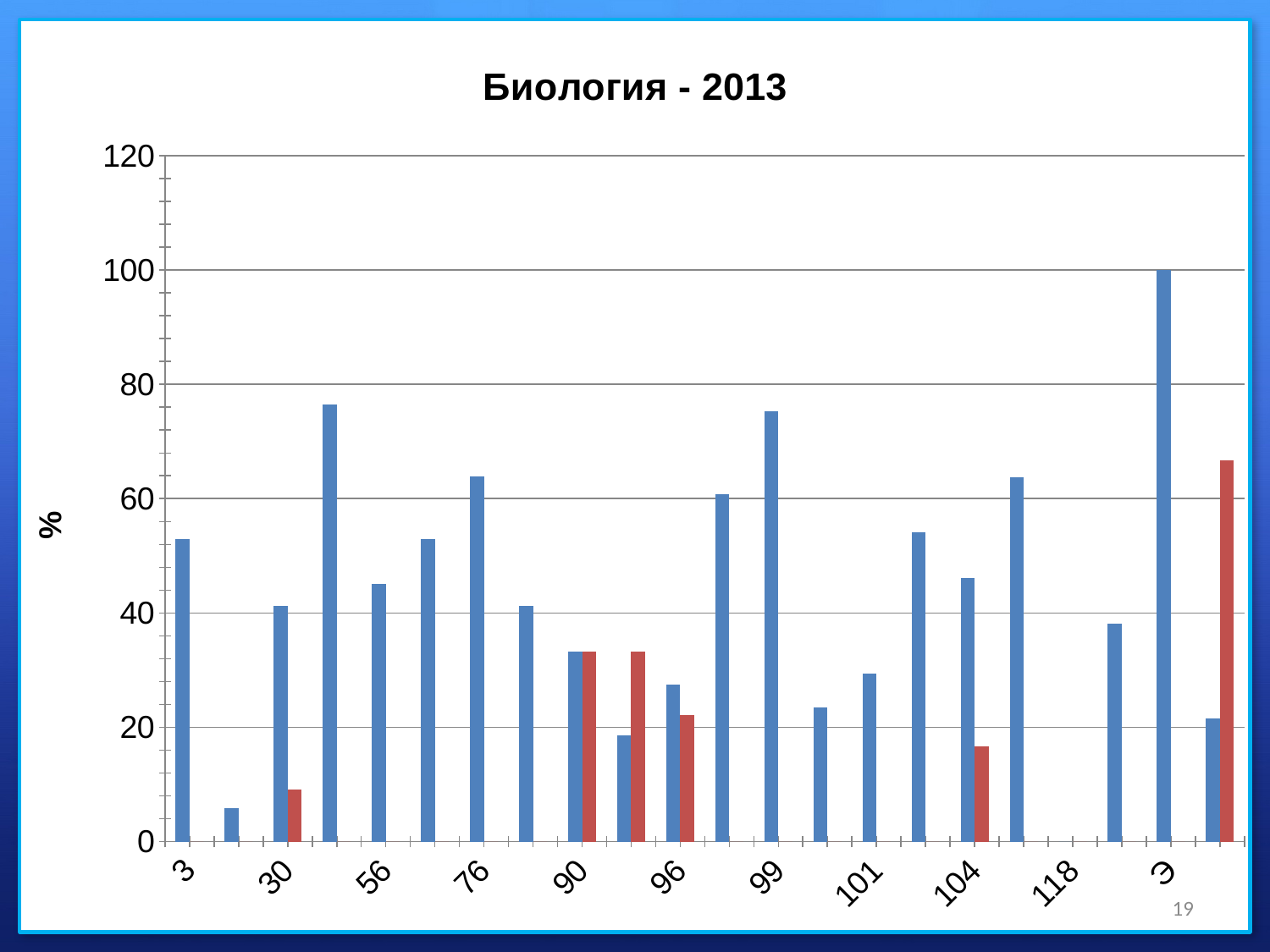
Is the value of the blue bar for category 101 greater or less than 40? less Which has the larger blue bar, category 76 or category 96? 76 Is the value of the blue bar for category 99 greater or less than 80? less Is the value of the blue bar for category 90 greater or less than 20? greater What is the value of the blue bar for category Э? 100 What is the title of the chart? Биология - 2013 Which category has the highest blue bar in the chart? Э Which has the larger blue bar, category 99 or category 101? 99 What is the label on the vertical axis of the chart? % What kind of chart is shown on the slide? bar chart